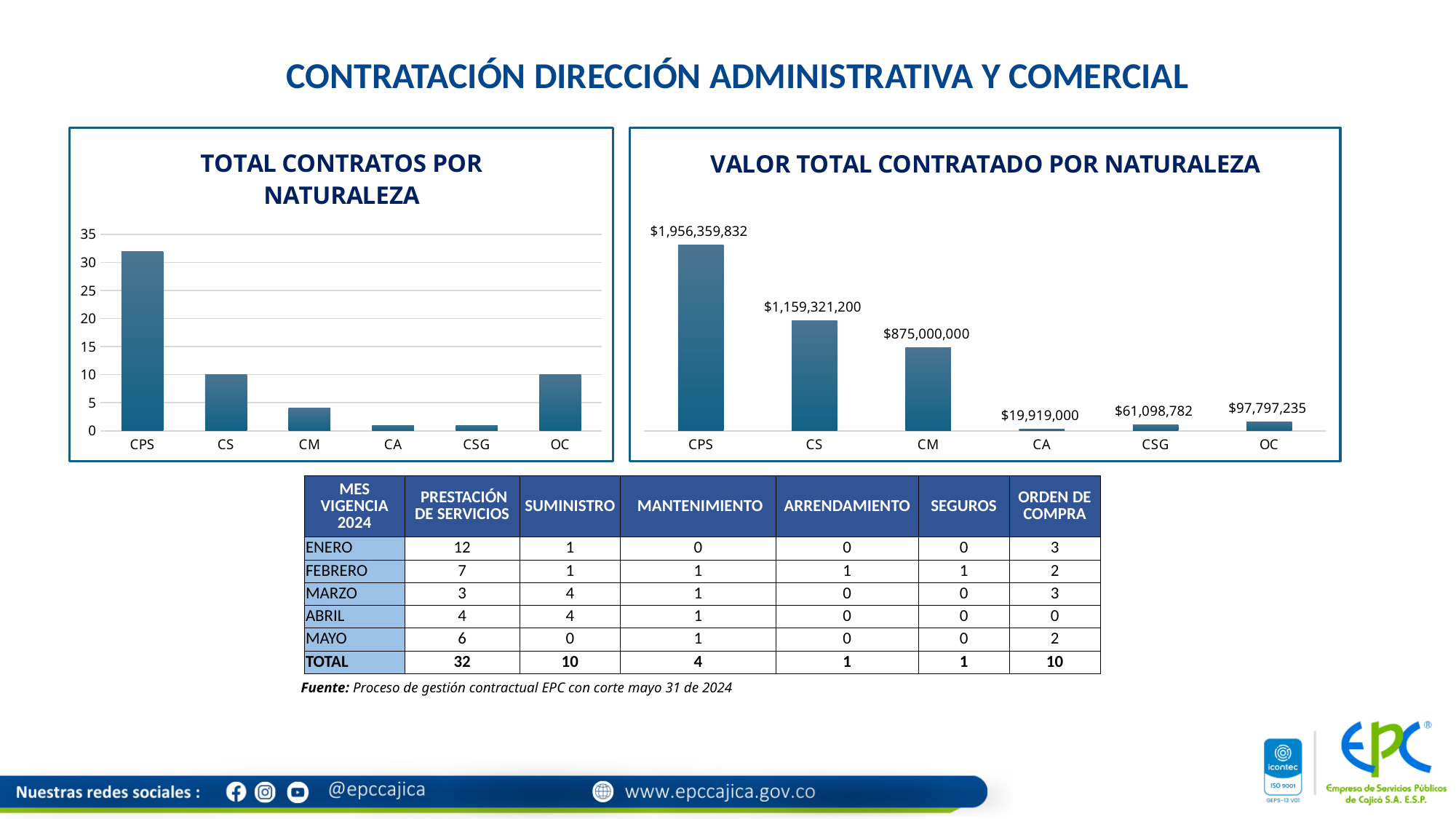
What kind of chart is 'VALOR TOTAL CONTRATADO POR NATURALEZA'? bar chart In the chart 'VALOR TOTAL CONTRATADO POR NATURALEZA', what is the value for CPS? $1,956,359,832 In the chart 'TOTAL CONTRATOS POR NATURALEZA', is the value for CPS greater or less than 30? greater In the chart 'VALOR TOTAL CONTRATADO POR NATURALEZA', what is the difference between the values for CS and CM? $284,321,200 In the chart 'VALOR TOTAL CONTRATADO POR NATURALEZA', which category has the highest value? CPS How many categories are shown in the chart 'TOTAL CONTRATOS POR NATURALEZA'? 6 In the chart 'VALOR TOTAL CONTRATADO POR NATURALEZA', which is larger, the value for CSG or the value for OC? OC In the chart 'TOTAL CONTRATOS POR NATURALEZA', what is the value for CS? 10 In the chart 'VALOR TOTAL CONTRATADO POR NATURALEZA', which category has the lowest value? CA In the chart 'VALOR TOTAL CONTRATADO POR NATURALEZA', what is the value for CA? $19,919,000 In the chart 'VALOR TOTAL CONTRATADO POR NATURALEZA', what is the value for CM? $875,000,000 In the chart 'TOTAL CONTRATOS POR NATURALEZA', which category has the highest value? CPS